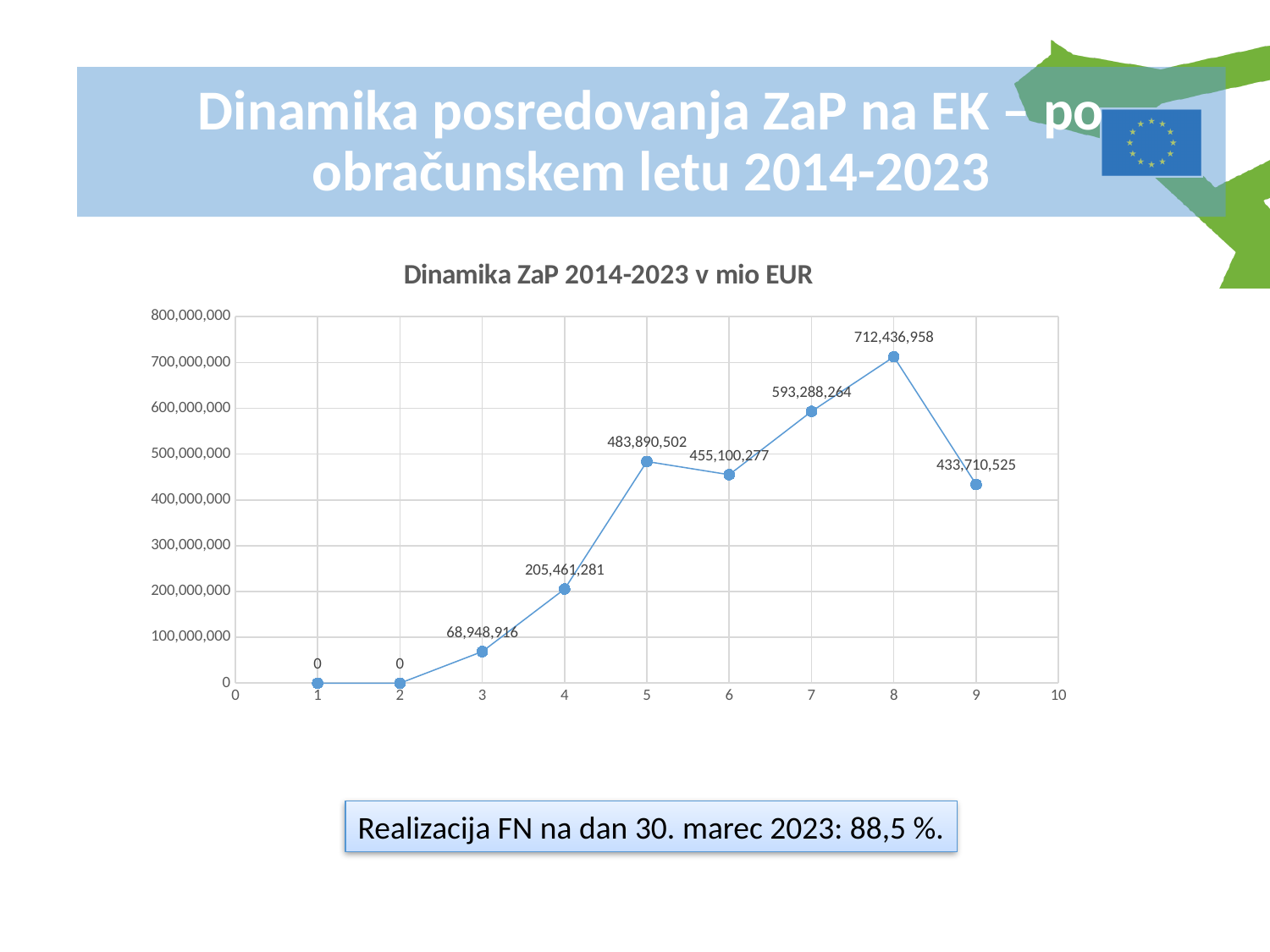
What kind of chart is shown on the slide? line chart How many data points are plotted on the chart? 9 What is the title of the chart? Dinamika ZaP 2014-2023 v mio EUR What is the difference between the values at x = 8 and x = 9? 278,726,433 What is the value at x = 6? 455,100,277 Is the value at x = 7 greater or less than 500,000,000? greater At which x value is the plotted value highest? 8 Do the values rise or fall between x = 8 and x = 9? fall What is the value at x = 9? 433,710,525 Which is larger, the value at x = 5 or the value at x = 6? x = 5 What is the value at x = 8? 712,436,958 What is the value at x = 3? 68,948,916